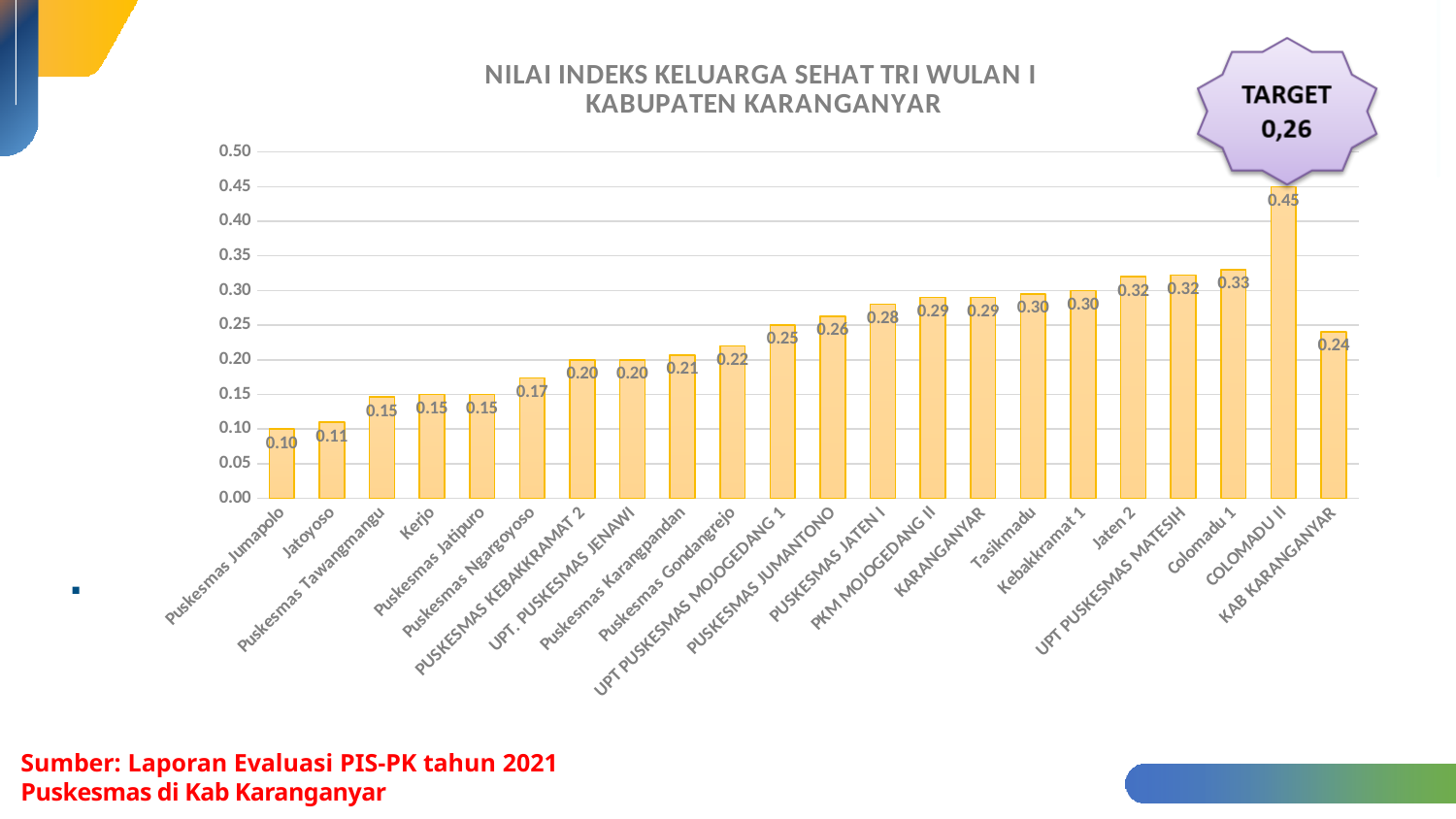
Which is larger, the value for Puskesmas Gondangrejo or the value for PUSKESMAS JATEN I? PUSKESMAS JATEN I Which category has the highest value? COLOMADU II Which category has the lowest value? Puskesmas Jumapolo What target value is shown in the badge at the top right of the slide? 0,26 What kind of chart is shown on the slide? bar chart Is the value for Jaten 2 greater or less than 0.30? greater What is the difference between the values for COLOMADU II and Colomadu 1? 0.12 What is the value for COLOMADU II? 0.45 What is the value for KAB KARANGANYAR? 0.24 What is the value for Colomadu 1? 0.33 What is the value for Puskesmas Ngargoyoso? 0.17 How many categories are shown on the x axis? 22